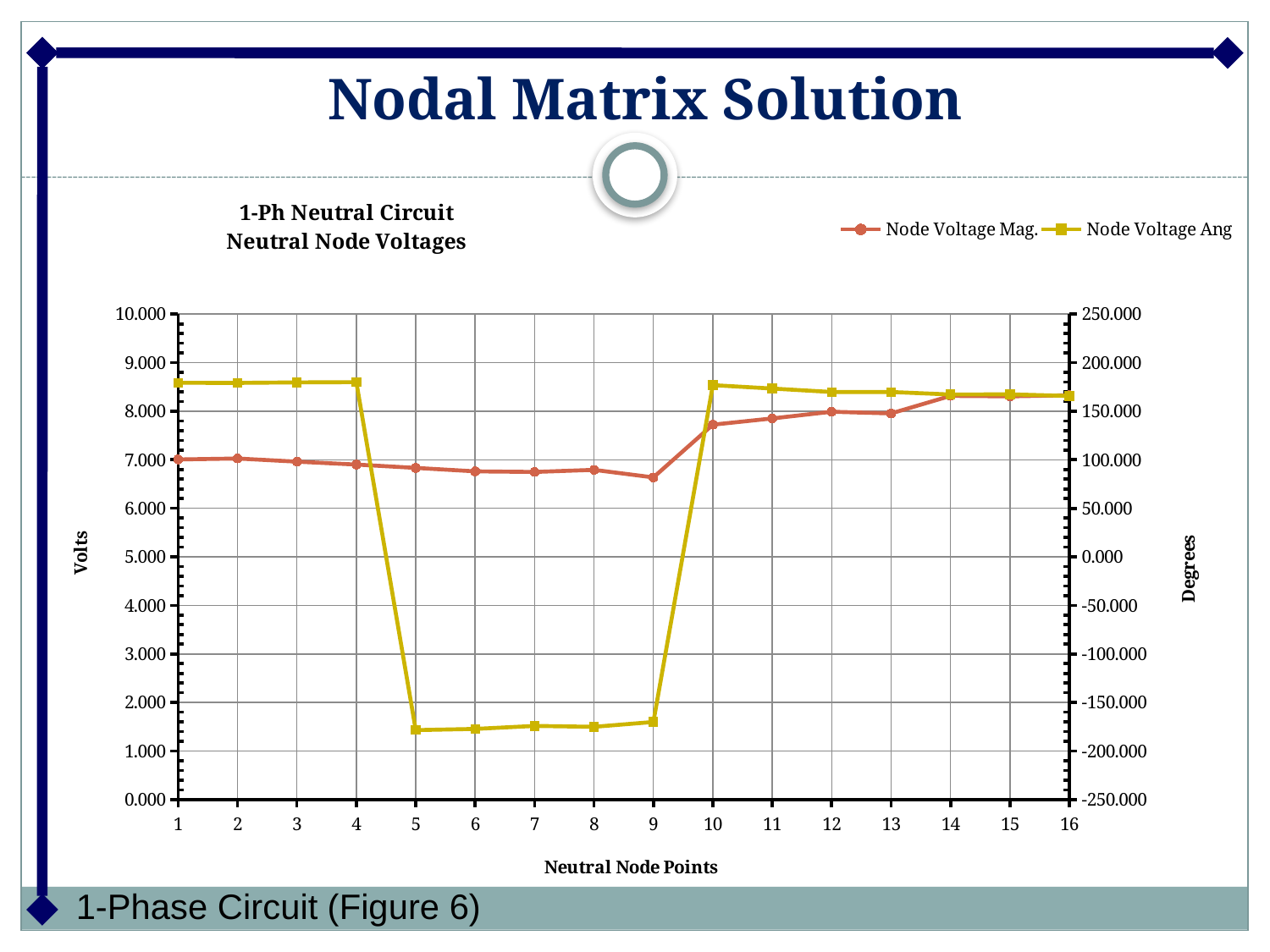
Is the Node Voltage Mag. value at node point 12 greater or less than 7.000 volts? greater What is the title of the chart? 1-Ph Neutral Circuit Neutral Node Voltages What is the label of the right-hand vertical axis? Degrees Does the Node Voltage Ang series rise or fall between node point 4 and node point 5? fall How many neutral node points are plotted along the x axis? 16 What kind of chart is shown on the slide? line chart At which neutral node point is the Node Voltage Mag. lowest? 9 Which has the larger Node Voltage Mag. value, node point 5 or node point 12? node point 12 How many series does the chart legend list? 2 Is the Node Voltage Mag. value at node point 9 greater or less than 7.000 volts? less Is the Node Voltage Ang value at node point 5 greater or less than 0.000 degrees? less